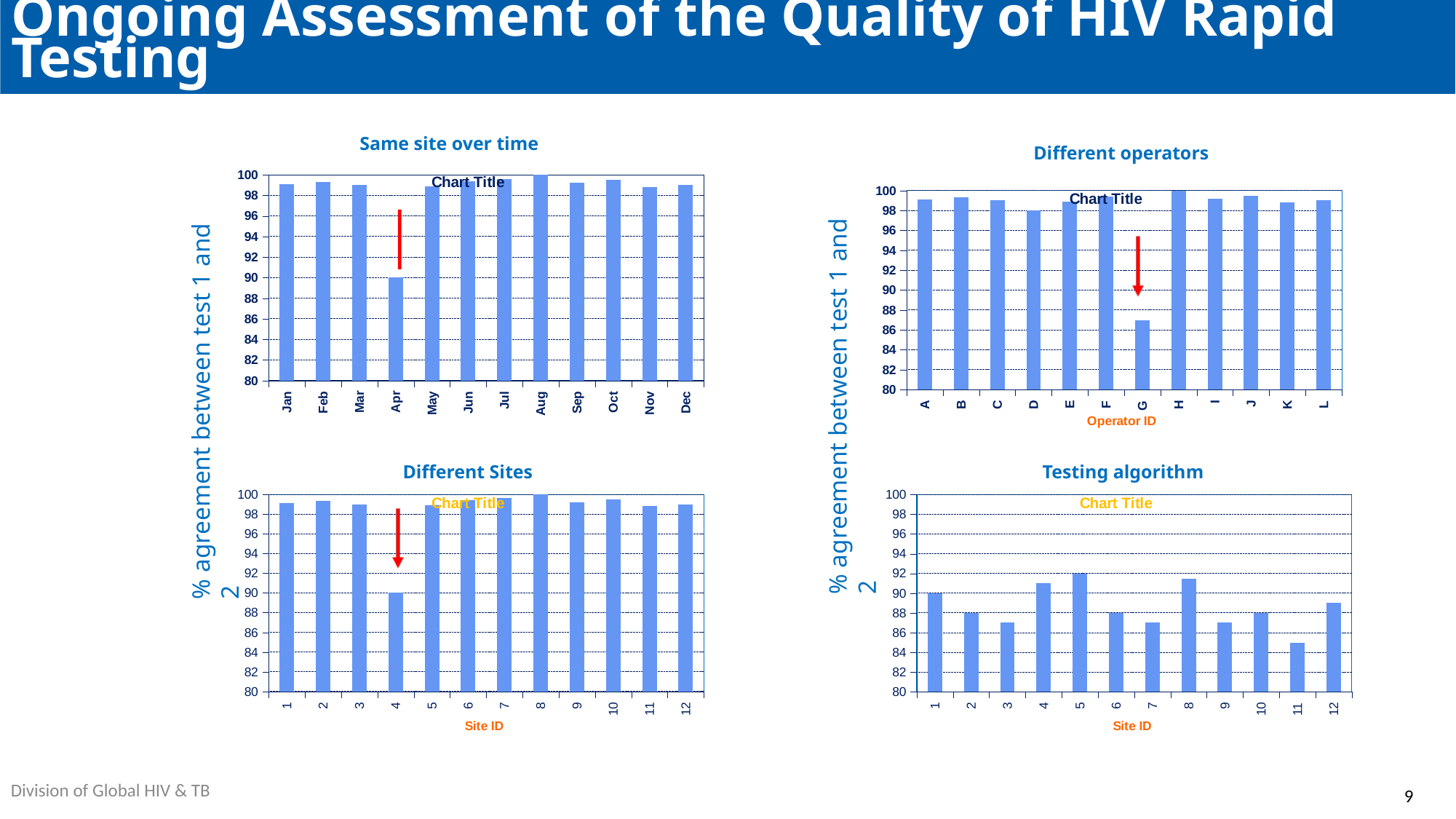
In the 'Different operators' chart, is the value for operator G greater or less than 88? less In the 'Same site over time' chart, what is the difference between the values for Aug and Apr? 10 In the 'Testing algorithm' chart, which has the larger value, site 1 or site 11? site 1 In the 'Testing algorithm' chart, what is the value for site 5? 92 In the 'Testing algorithm' chart, which site has the lowest value? 11 In the 'Testing algorithm' chart, is the value for site 11 greater or less than 86? less In the 'Different Sites' chart, what is the value for site 4? 90 How many sites are shown on the x axis of the 'Testing algorithm' chart? 12 In the 'Same site over time' chart, what is the value for Apr? 90 In the 'Same site over time' chart, which month has the lowest value? Apr In the 'Different Sites' chart, which site has the lowest value? 4